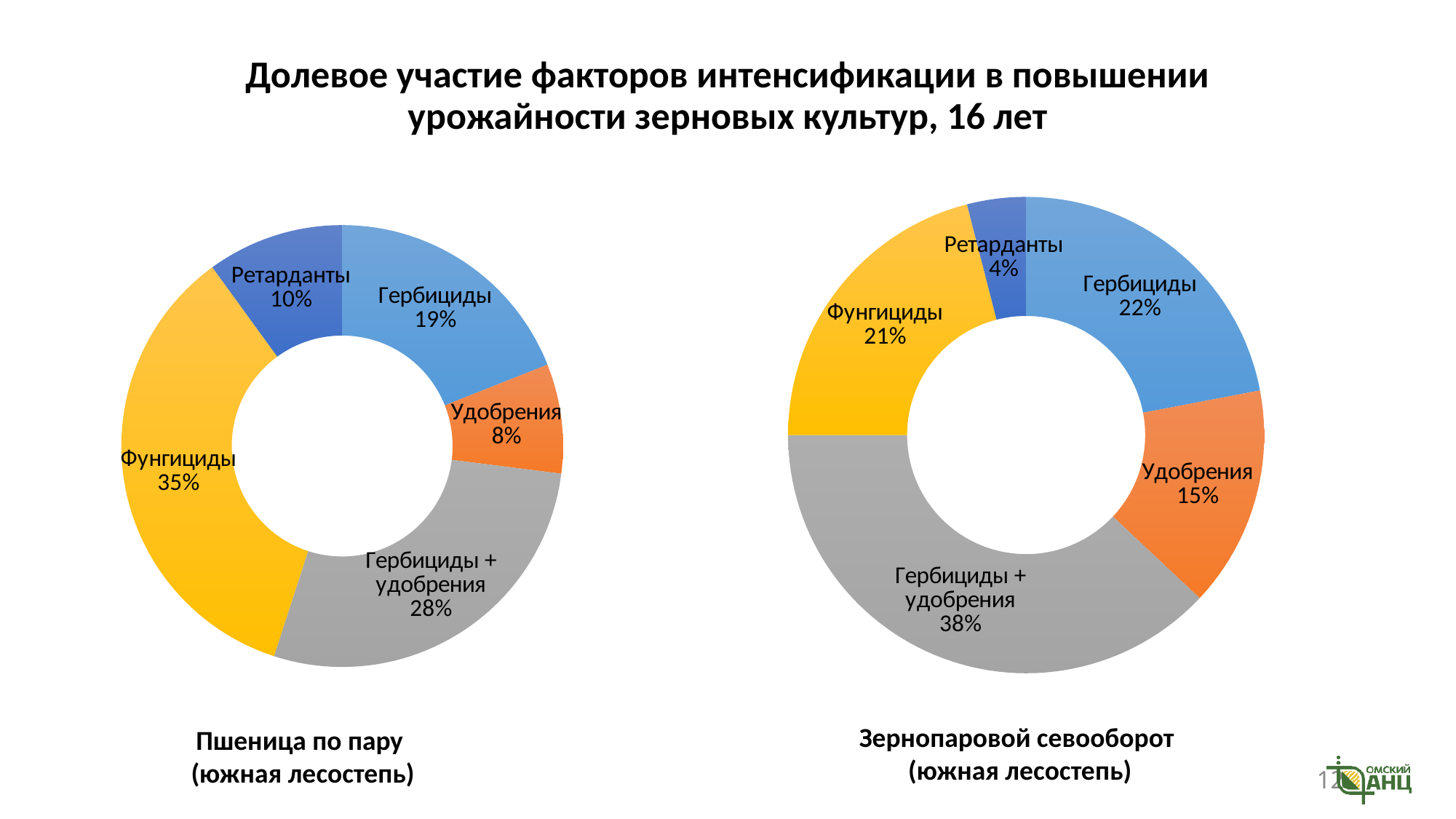
What is the title of the slide? Долевое участие факторов интенсификации в повышении урожайности зерновых культур, 16 лет In the left chart (Пшеница по пару), which category has the smallest share? Удобрения In the right chart (Зернопаровой севооборот), which category has the smallest share? Ретарданты In the left chart (Пшеница по пару), what share is labelled for Ретарданты? 10% In the right chart (Зернопаровой севооборот), what share is labelled for Удобрения? 15% In the left chart (Пшеница по пару), what is the difference between the shares of Фунгициды and Гербициды + удобрения? 7% What is the difference between the share of Ретарданты in the left chart and in the right chart? 6% What type of chart is used on this slide? Doughnut (pie) chart In the right chart (Зернопаровой севооборот), which is larger: the share of Гербициды or the share of Фунгициды? Гербициды In the right chart (Зернопаровой севооборот), which category has the largest share? Гербициды + удобрения How many categories does the left chart (Пшеница по пару) show? 5 In the left chart (Пшеница по пару), what share is labelled for Фунгициды? 35%